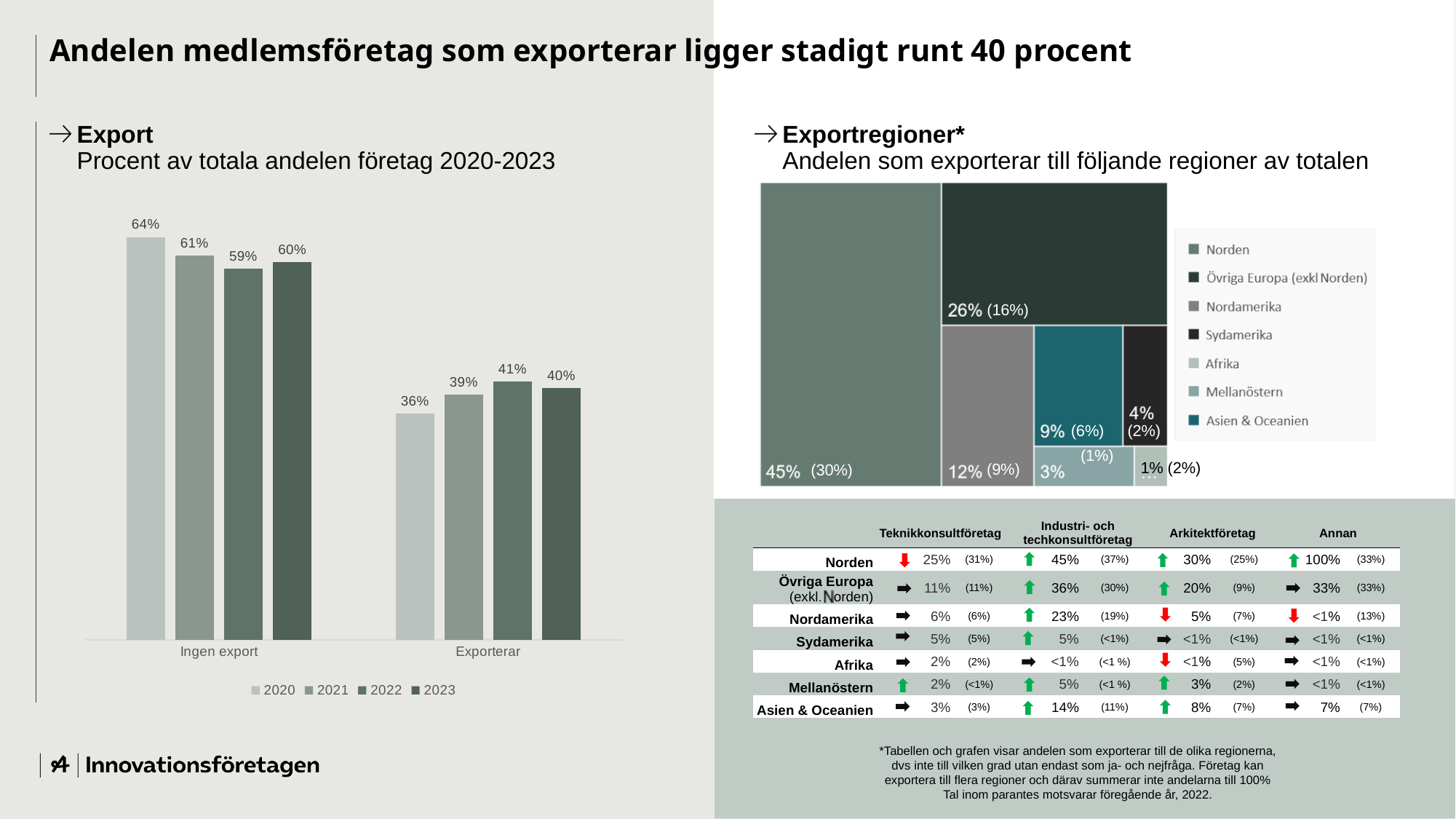
In the Export bar chart, which year has the lowest value for Ingen export? 2022 In the Exportregioner chart, what share of companies export to Norden? 45% What kind of chart is the Export chart on the left of the slide? Bar chart How many regions does the legend of the Exportregioner chart list? 7 In the Exportregioner chart, which region has the largest share? Norden How many series does the legend of the Export bar chart list? 4 In the Export bar chart, which is larger: Exporterar in 2020 or Exporterar in 2022? Exporterar in 2022 In the Export bar chart, what is the value for Exporterar in 2023? 40% In the Export bar chart, which year has the highest value for Exporterar? 2022 In the Export bar chart, what is the value for Ingen export in 2020? 64% In the Export bar chart, what is the difference between Ingen export and Exporterar in 2021? 22 percentage points In the Export bar chart, do the Exporterar values rise or fall from 2020 to 2022? Rise